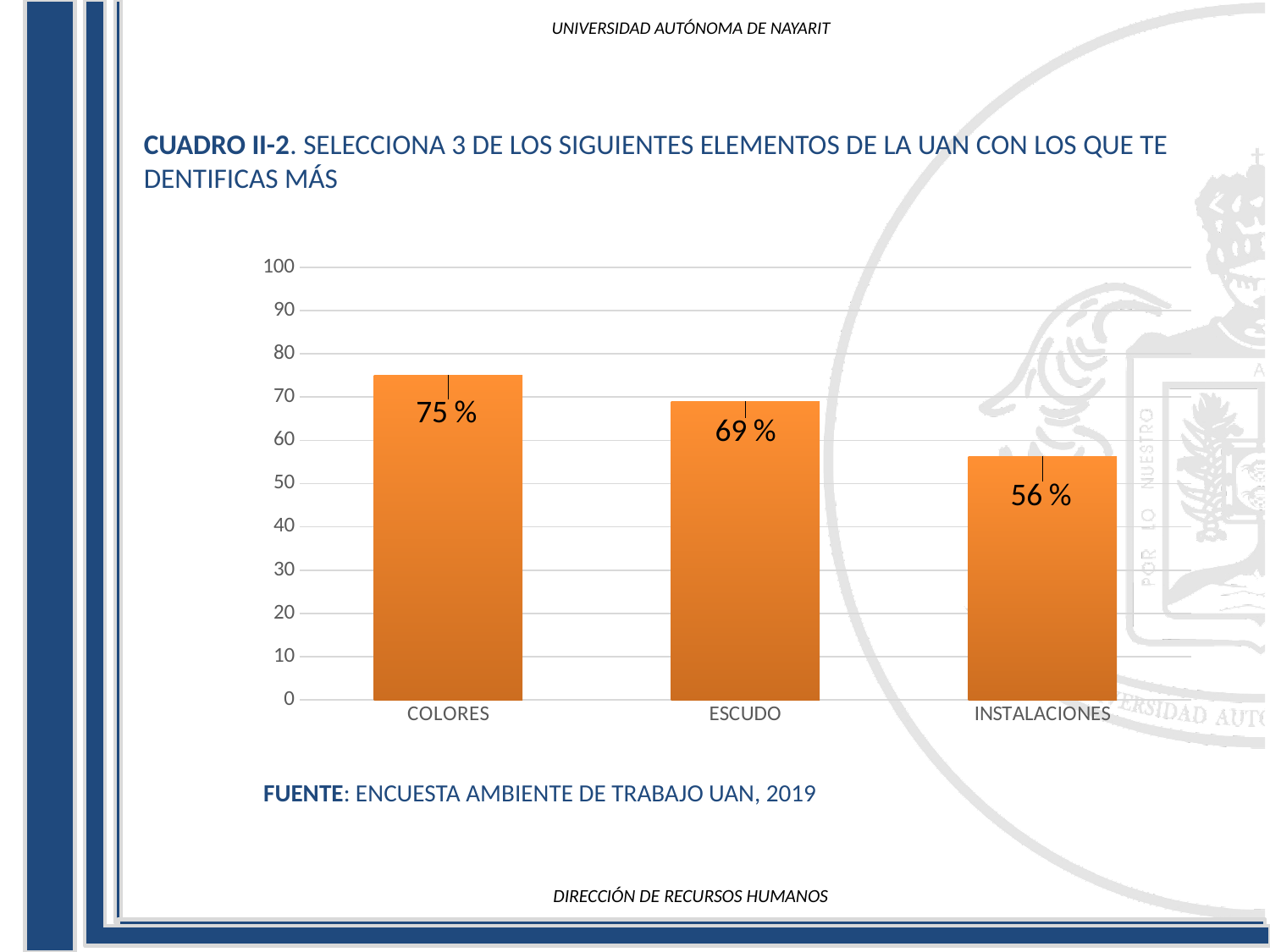
What is the value for ESCUDO? 69 % What is the difference between the values for COLORES and ESCUDO? 6 % Is the value for INSTALACIONES greater or less than 60? less Which is larger, the value for ESCUDO or the value for INSTALACIONES? ESCUDO How many categories are shown in the chart? 3 What kind of chart is shown on the slide? bar chart What is the value for COLORES? 75 % What is the value for INSTALACIONES? 56 % Which category has the lowest value? INSTALACIONES Which category has the highest value? COLORES Do the values rise or fall from left to right across the categories? fall What is the difference between the values for COLORES and INSTALACIONES? 19 %